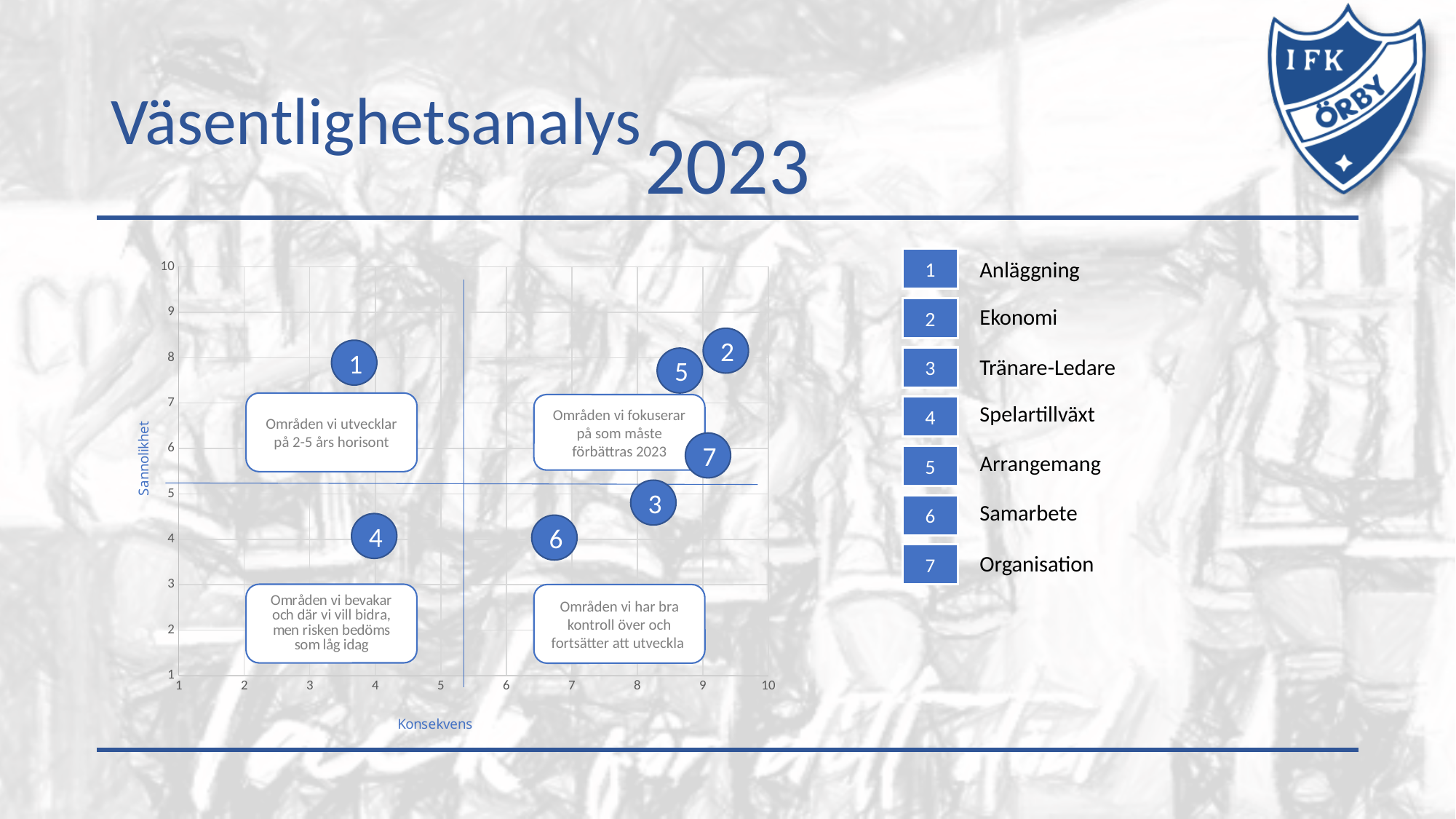
What kind of chart is shown on the slide? Scatter (bubble) chart Is the Konsekvens value for point 7 (Organisation) greater or less than 8? greater Is the Konsekvens value for point 4 (Spelartillväxt) greater or less than 5? less Is the Konsekvens value for point 2 (Ekonomi) greater or less than 9? greater What is the label of the vertical axis of the chart? Sannolikhet Which has the higher Konsekvens value, point 6 (Samarbete) or point 4 (Spelartillväxt)? Point 6 (Samarbete) How many numbered points are plotted on the chart? 7 Which has the higher Sannolikhet value, point 1 (Anläggning) or point 4 (Spelartillväxt)? Point 1 (Anläggning) What is the label of the horizontal axis of the chart? Konsekvens